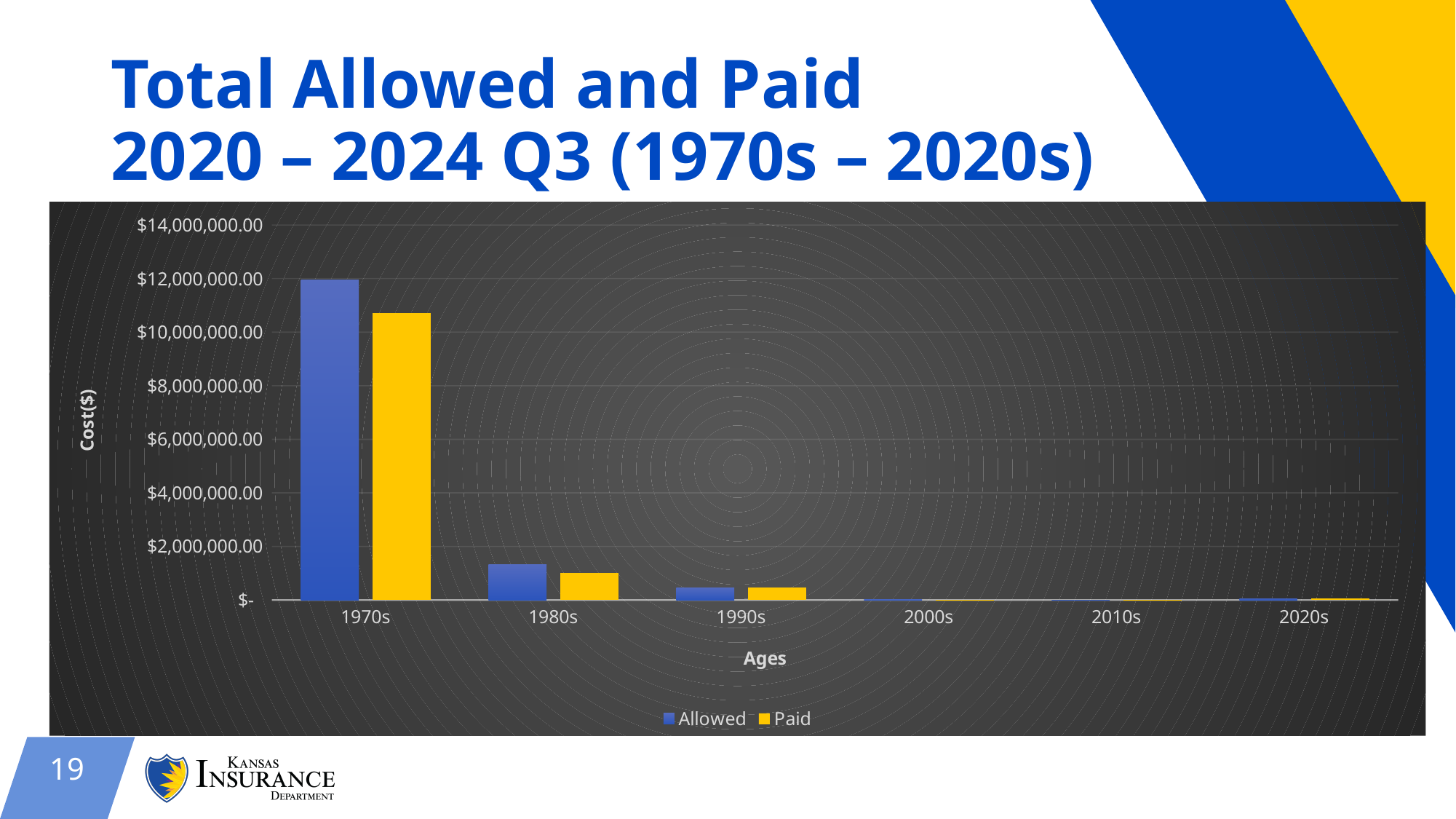
How many age-decade categories are shown on the x axis? 6 For the 1970s, which is larger, Allowed or Paid? Allowed What is the label on the vertical axis? Cost($) Is the Paid value for the 1970s greater or less than $10,000,000.00? greater Is the Allowed value for the 1970s greater or less than $10,000,000.00? greater What kind of chart is shown on the slide? Bar chart Which colour represents the Paid series in the legend? Yellow Do the Allowed values rise or fall from the 1970s to the 2020s? Fall Which decade has the highest Allowed value? 1970s Which decade has the highest Paid value? 1970s How many series does the legend list? 2 Is the Allowed value for the 1980s greater or less than $2,000,000.00? less